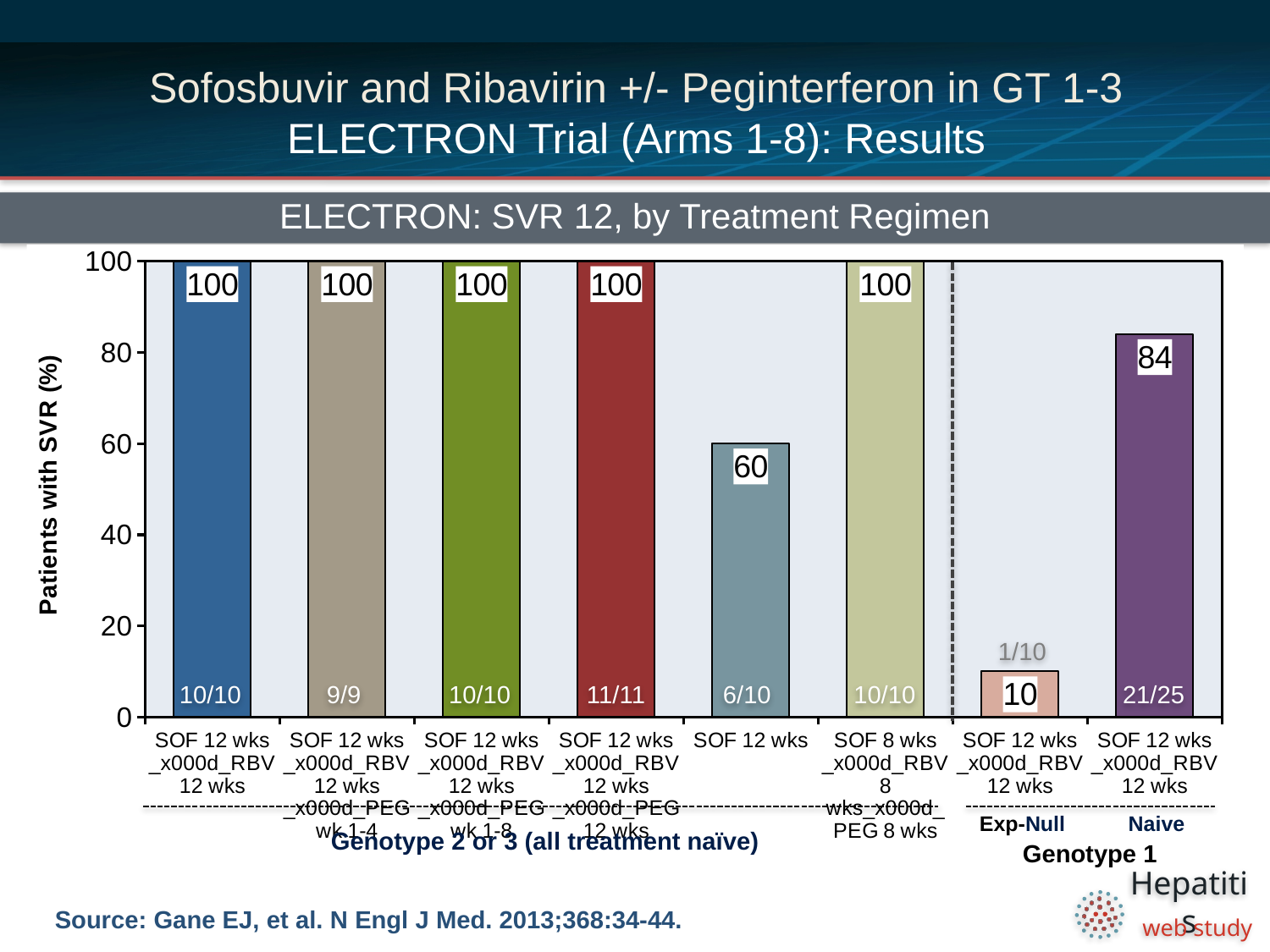
What is the difference in SVR 12 between the Genotype 1 Naive arm and the Genotype 1 Exp-Null arm? 74 What is the title of the chart? ELECTRON: SVR 12, by Treatment Regimen What fraction of patients is shown for the SOF 12 wks monotherapy arm (the fifth bar)? 6/10 How many arms reached an SVR 12 of 100? 5 What fraction of patients is shown inside the Genotype 1 Naive bar? 21/25 Which arm has the lowest SVR 12 value? Genotype 1 Exp-Null (SOF 12 wks + RBV 12 wks) What is the SVR 12 value for the SOF 12 wks monotherapy arm (the fifth bar)? 60 What type of chart is shown on the slide? Bar chart Which is larger, the SVR 12 for the SOF 12 wks monotherapy arm or the Genotype 1 Naive arm? Genotype 1 Naive What is the SVR 12 value for the Genotype 1 Exp-Null arm? 10 How many bars are plotted in the chart? 8 What is the SVR 12 value for the Genotype 1 Naive arm? 84